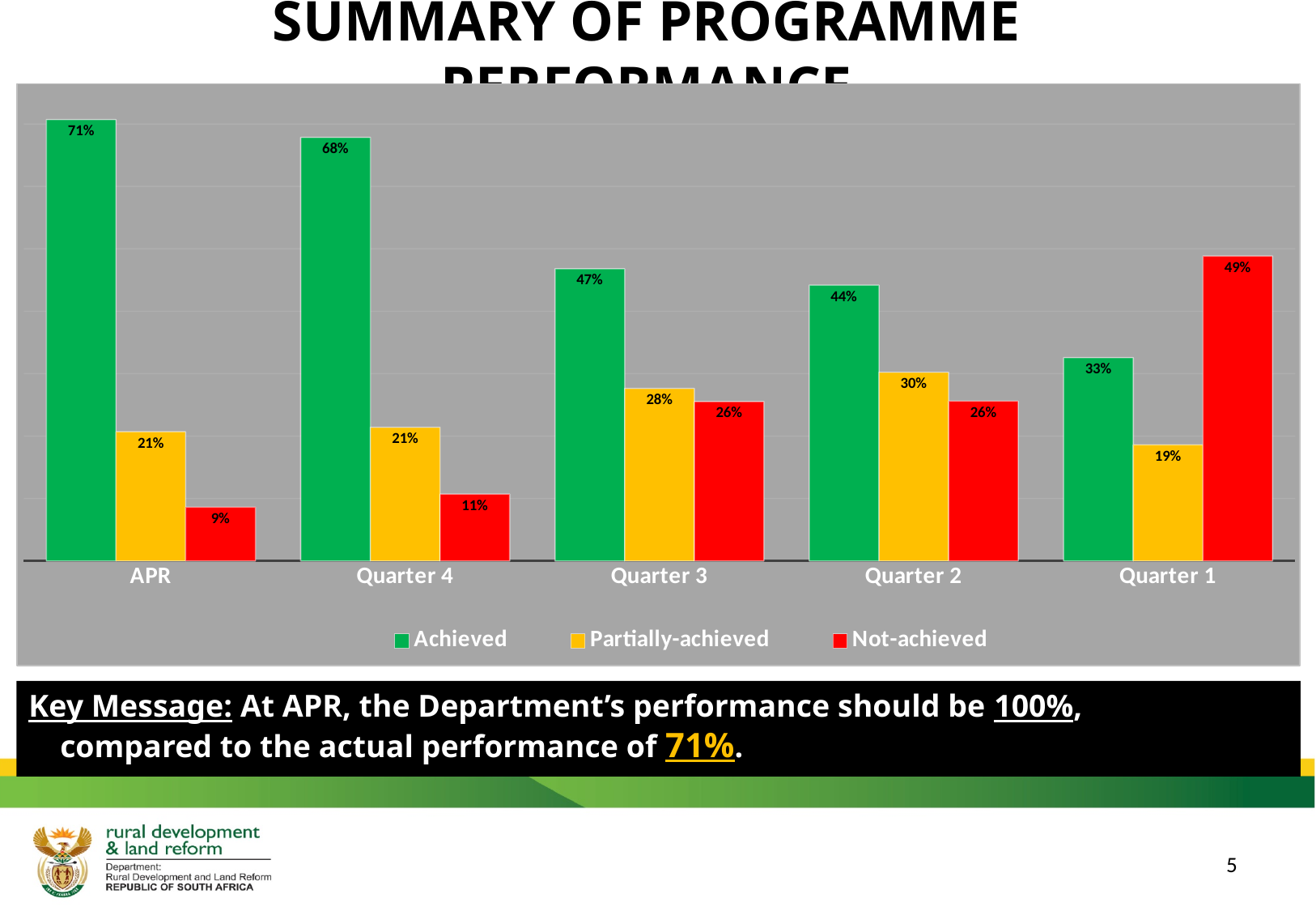
Which category has the highest Achieved value? APR What is the Achieved value for APR? 71% What is the Partially-achieved value for Quarter 2? 30% What is the Not-achieved value for Quarter 1? 49% Which is larger: the Not-achieved value for Quarter 1 or the Achieved value for Quarter 1? Not-achieved Do the Achieved values rise or fall from APR to Quarter 1 along the x axis? Fall Which category has the lowest Not-achieved value? APR What is the difference between the Achieved values for Quarter 4 and Quarter 3? 21% What kind of chart is shown on the slide? Bar chart Which colour represents the Partially-achieved series? Yellow How many series does the legend list? 3 How many categories are shown on the x axis? 5